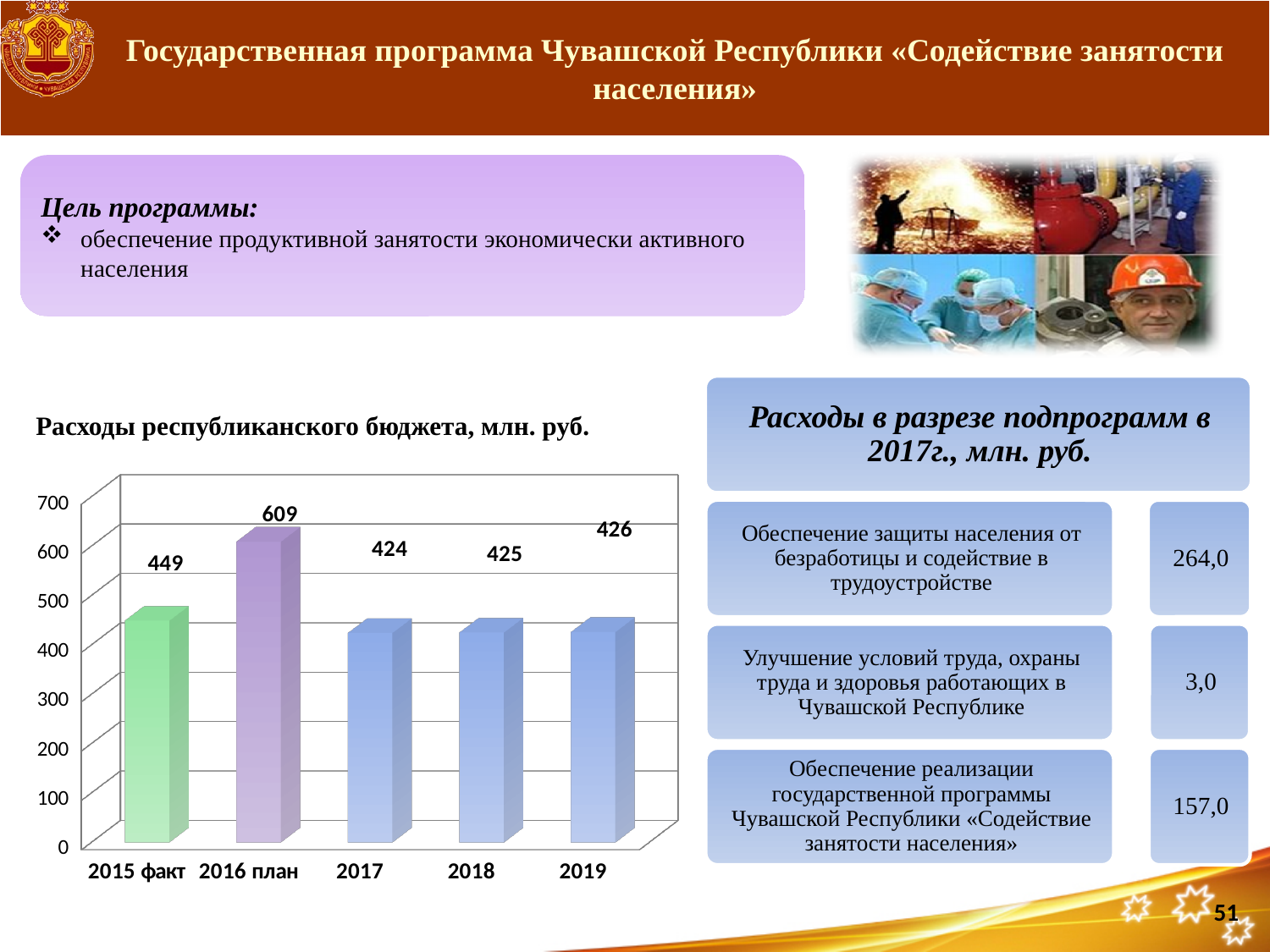
What is the difference between the values for 2015 факт and 2017 in the chart "Расходы республиканского бюджета, млн. руб."? 25 How many categories are shown on the x axis of the chart "Расходы республиканского бюджета, млн. руб."? 5 What is the value for 2019 in the chart "Расходы республиканского бюджета, млн. руб."? 426 What is the title of the chart on the left side of the slide? Расходы республиканского бюджета, млн. руб. What is the value for 2015 факт in the chart "Расходы республиканского бюджета, млн. руб."? 449 What is the value for 2016 план in the chart "Расходы республиканского бюджета, млн. руб."? 609 Which is larger in the chart "Расходы республиканского бюджета, млн. руб.": the value for 2015 факт or the value for 2018? 2015 факт Is the value for 2016 план greater or less than 500 in the chart "Расходы республиканского бюджета, млн. руб."? greater What kind of chart is "Расходы республиканского бюджета, млн. руб."? bar chart Which category has the lowest value in the chart "Расходы республиканского бюджета, млн. руб."? 2017 Which category has the highest value in the chart "Расходы республиканского бюджета, млн. руб."? 2016 план What is the difference between the values for 2016 план and 2015 факт in the chart "Расходы республиканского бюджета, млн. руб."? 160